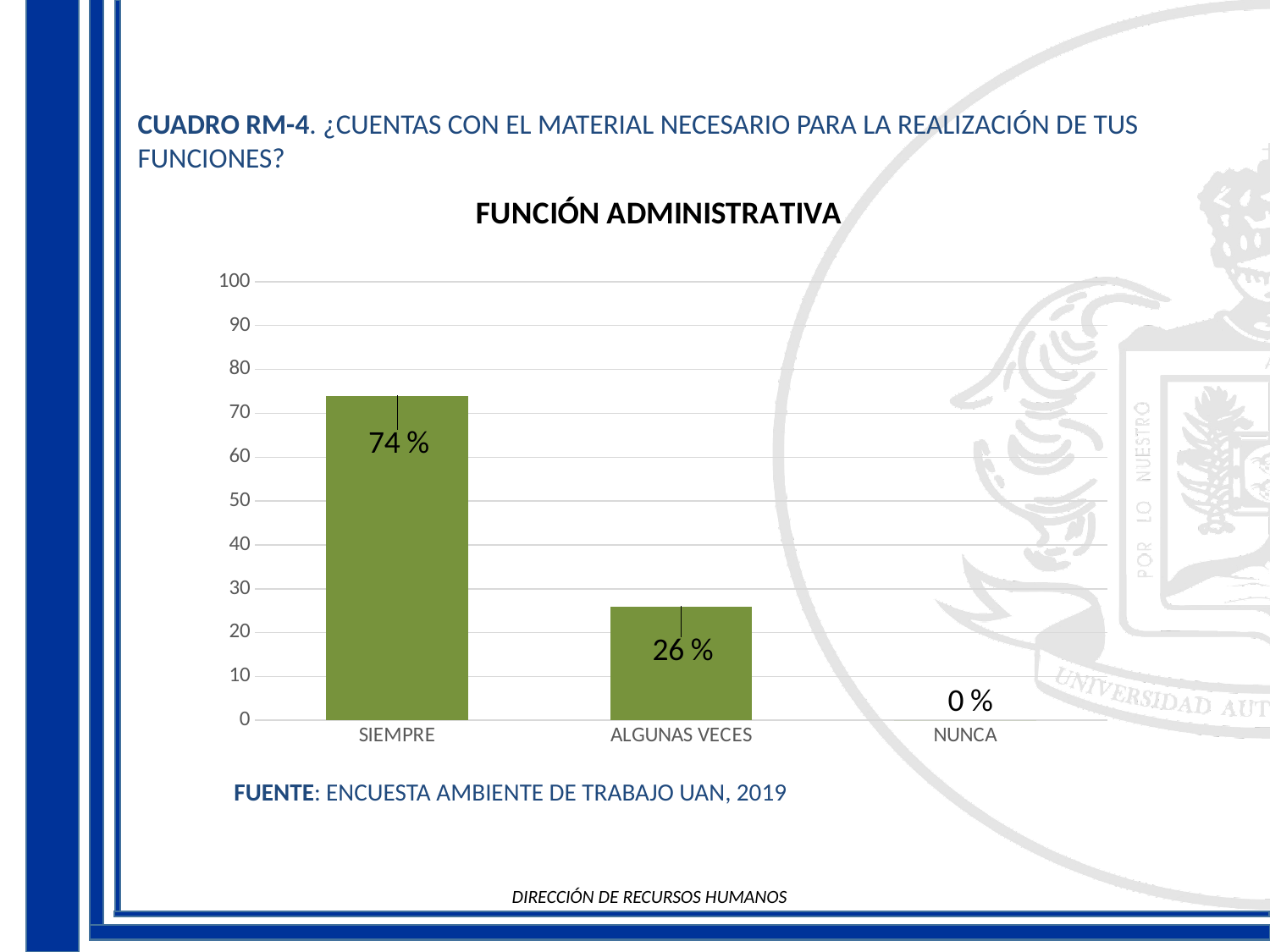
What is the value for SIEMPRE? 74 % What is the difference between the values for SIEMPRE and ALGUNAS VECES? 48 % Is the value for ALGUNAS VECES greater or less than 30? less What is the value for ALGUNAS VECES? 26 % Which category has the lowest value? NUNCA Which is larger, the value for SIEMPRE or the value for ALGUNAS VECES? SIEMPRE Which category has the highest value? SIEMPRE Is the value for SIEMPRE greater or less than 70? greater What is the value for NUNCA? 0 % What is the title of the chart? FUNCIÓN ADMINISTRATIVA What kind of chart is shown on the slide? Bar chart How many categories are shown on the x axis? 3